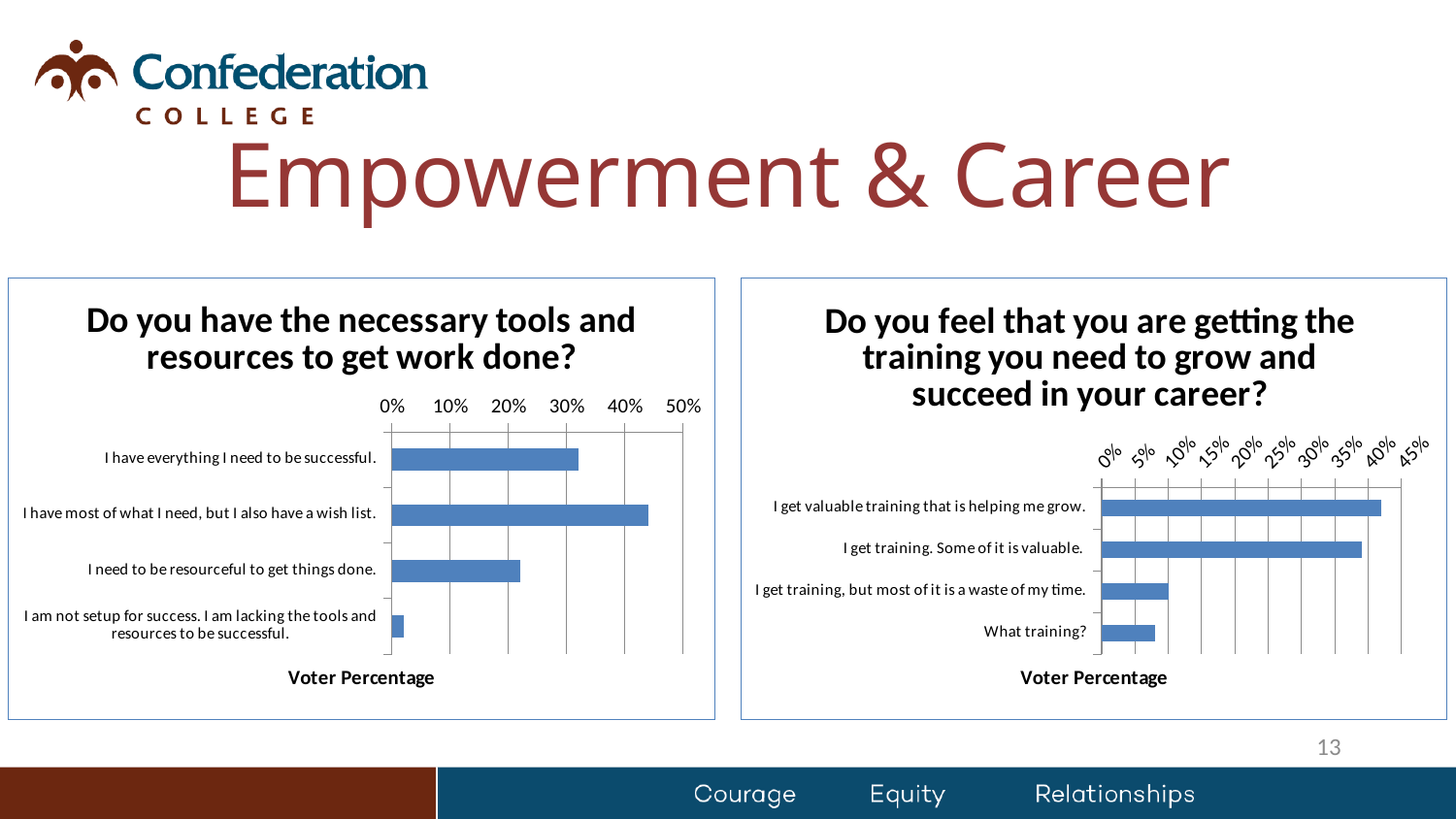
On the chart titled "Do you have the necessary tools and resources to get work done?", is the value for "I have everything I need to be successful." greater or less than 20%? greater On the chart titled "Do you have the necessary tools and resources to get work done?", what kind of chart is shown? bar chart On the chart titled "Do you have the necessary tools and resources to get work done?", which category has the lowest value? I am not setup for success. I am lacking the tools and resources to be successful. On the chart titled "Do you feel that you are getting the training you need to grow and succeed in your career?", which category has the highest value? I get valuable training that is helping me grow. On the chart titled "Do you feel that you are getting the training you need to grow and succeed in your career?", is the value for "I get training. Some of it is valuable." greater or less than 30%? greater On the chart titled "Do you have the necessary tools and resources to get work done?", how many categories are plotted? 4 On the chart titled "Do you feel that you are getting the training you need to grow and succeed in your career?", which is larger: "I get training, but most of it is a waste of my time." or "What training?"? I get training, but most of it is a waste of my time. On the chart titled "Do you feel that you are getting the training you need to grow and succeed in your career?", how many categories are plotted? 4 On the chart titled "Do you have the necessary tools and resources to get work done?", is the value for "I need to be resourceful to get things done." greater or less than 30%? less On the chart titled "Do you have the necessary tools and resources to get work done?", what is the x-axis label? Voter Percentage On the chart titled "Do you have the necessary tools and resources to get work done?", which category has the highest value? I have most of what I need, but I also have a wish list.